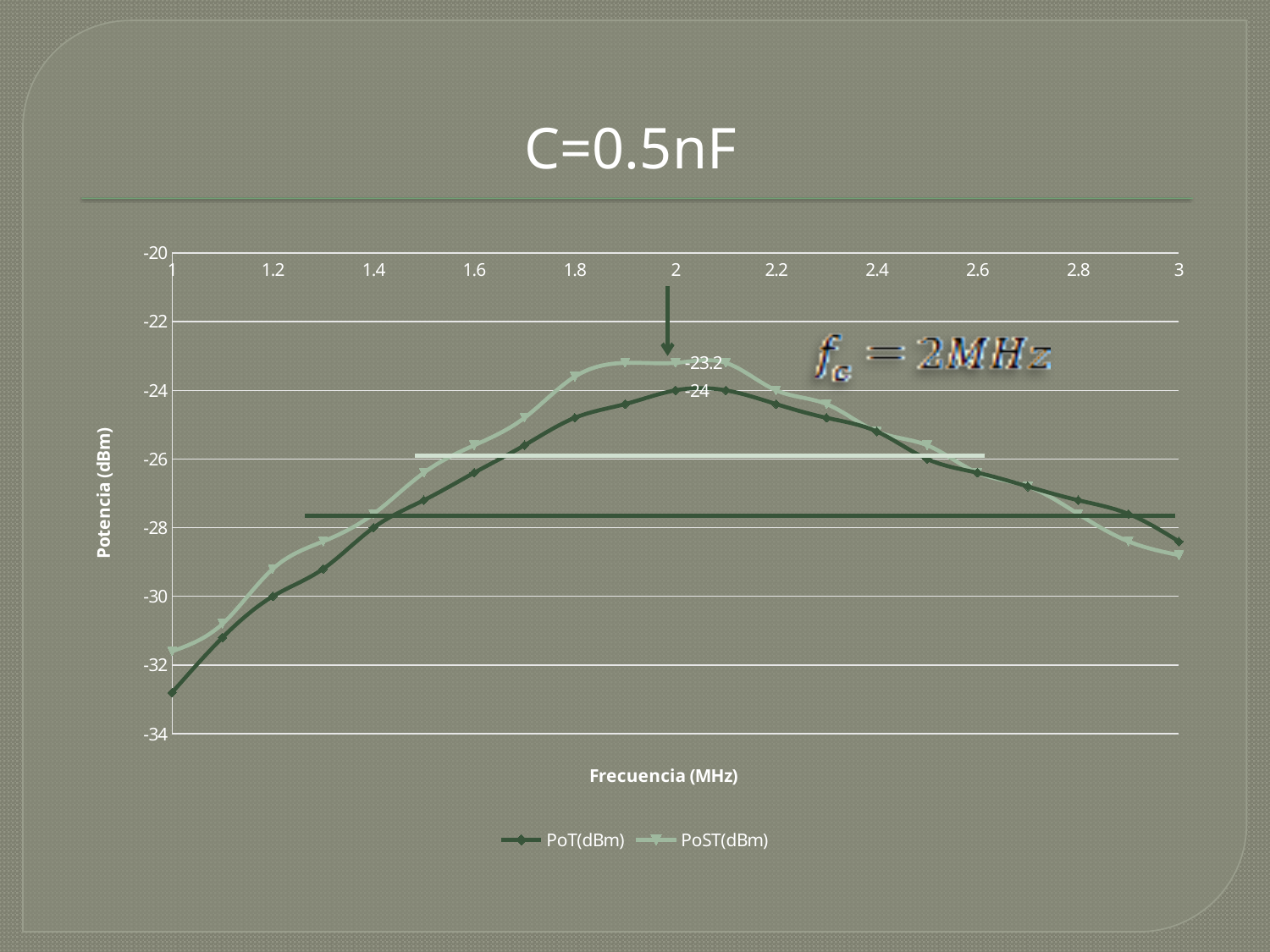
At 2 MHz, which series has the higher labelled value, PoT(dBm) or PoST(dBm)? PoST(dBm) What is the title of the chart? C=0.5nF Is the value of PoT(dBm) at 1 MHz greater or less than -32? less What is the difference between the labelled PoST(dBm) and PoT(dBm) values at 2 MHz? 0.8 How many series does the legend list? 2 What kind of chart is shown on the slide? line chart Is the value of PoT(dBm) at 3 MHz greater or less than -28? less Does the PoT(dBm) series rise or fall as frequency increases from 1 MHz to 2 MHz? rise What is the label of the vertical axis? Potencia (dBm) Is the value of PoST(dBm) at 1 MHz greater or less than -32? greater What is the labelled value of PoT(dBm) at 2 MHz? -24 What is the labelled value of PoST(dBm) at 2 MHz? -23.2